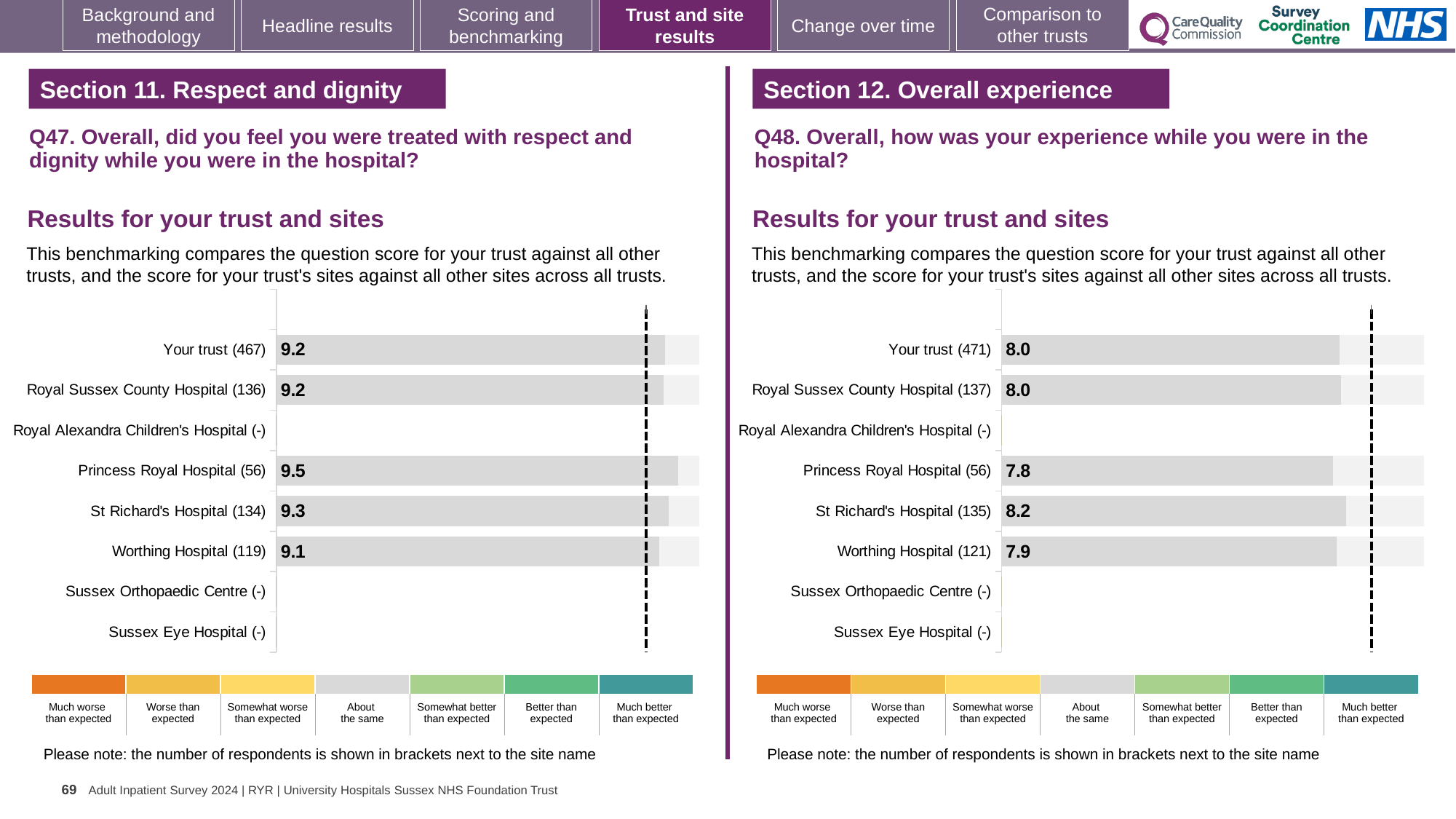
In the Q48 chart on the right, what is the score for Your trust? 8.0 In the Q48 chart on the right, what is the score for St Richard's Hospital? 8.2 In the Q47 chart on the left, what is the difference between the scores for Princess Royal Hospital and Worthing Hospital? 0.4 In the Q47 chart on the left, what is the score for Worthing Hospital? 9.1 In the Q47 chart on the left, which site has the highest score? Princess Royal Hospital In the Q48 chart on the right, how many respondents are shown in brackets for Royal Sussex County Hospital? 137 In the Q48 chart on the right, which site has the highest score? St Richard's Hospital In the Q47 chart on the left, what is the score for Princess Royal Hospital? 9.5 In the Q48 chart on the right, which is larger: the score for St Richard's Hospital or the score for Worthing Hospital? St Richard's Hospital What kind of chart is used in the Q47 chart on the left? Bar chart In the Q47 chart on the left, which site with a score shown has the lowest score? Worthing Hospital In the Q48 chart on the right, which site with a score shown has the lowest score? Princess Royal Hospital